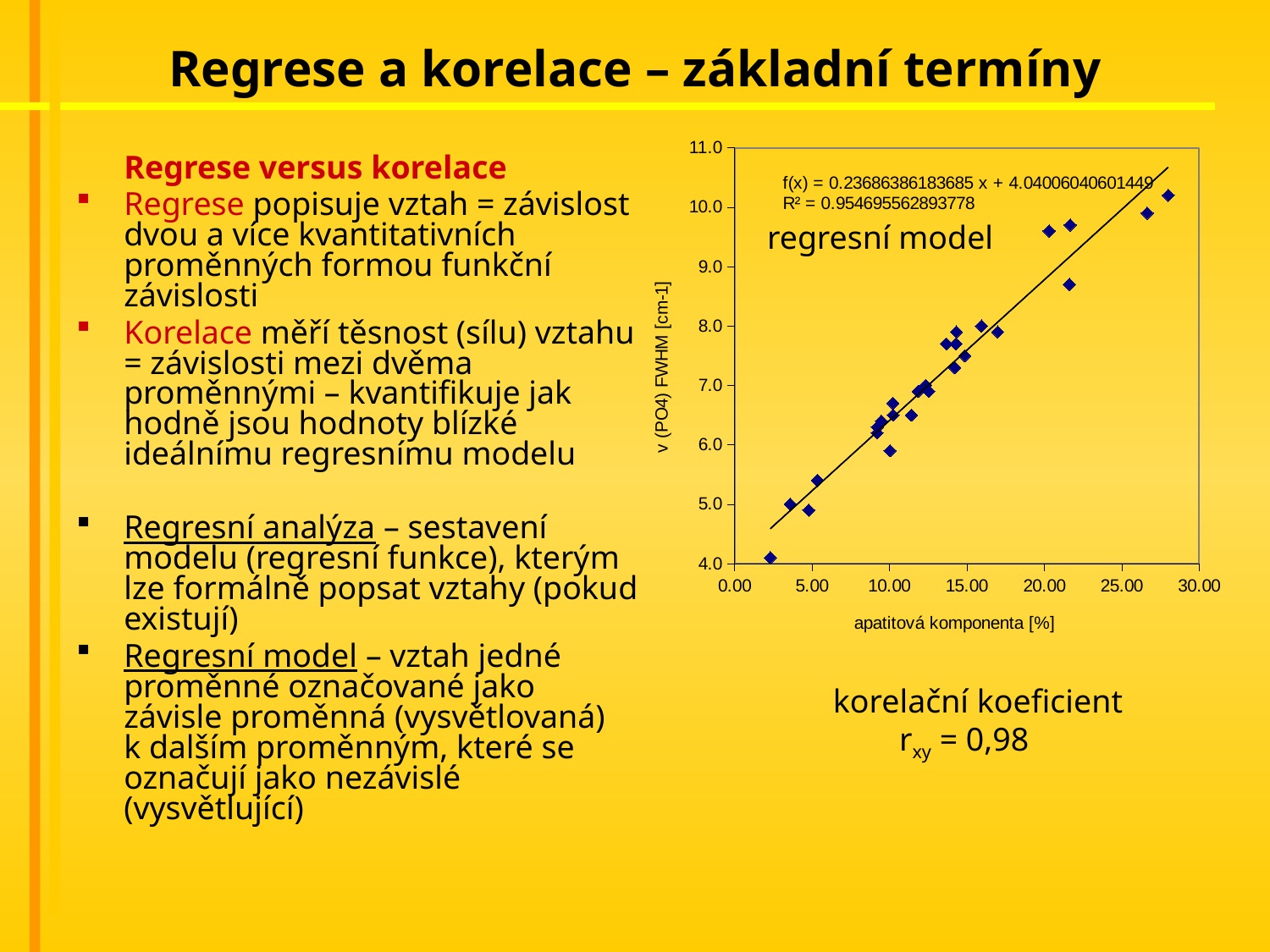
What R² value is printed on the chart? R² = 0.954695562893778 What is the maximum value shown on the y axis of the chart? 11.0 Is the y value of the data point near 21.5 on the x axis (the lower one) greater or less than 9.0? less What is the label of the y axis of the chart? v (PO4) FWHM [cm-1] What kind of chart is shown on the slide? scatter chart Do the plotted values rise or fall as the apatitová komponenta increases along the x axis? rise What is the maximum value shown on the x axis of the chart? 30.00 What is the label of the x axis of the chart? apatitová komponenta [%] Is the y value of the leftmost data point (near 2 on the x axis) greater or less than 5.0? less What correlation coefficient r_xy is stated below the chart? 0,98 What is the regression equation printed on the chart? f(x) = 0.23686386183685 x + 4.04006040601449 Is the y value of the rightmost data point (near 28 on the x axis) greater or less than 10.0? greater